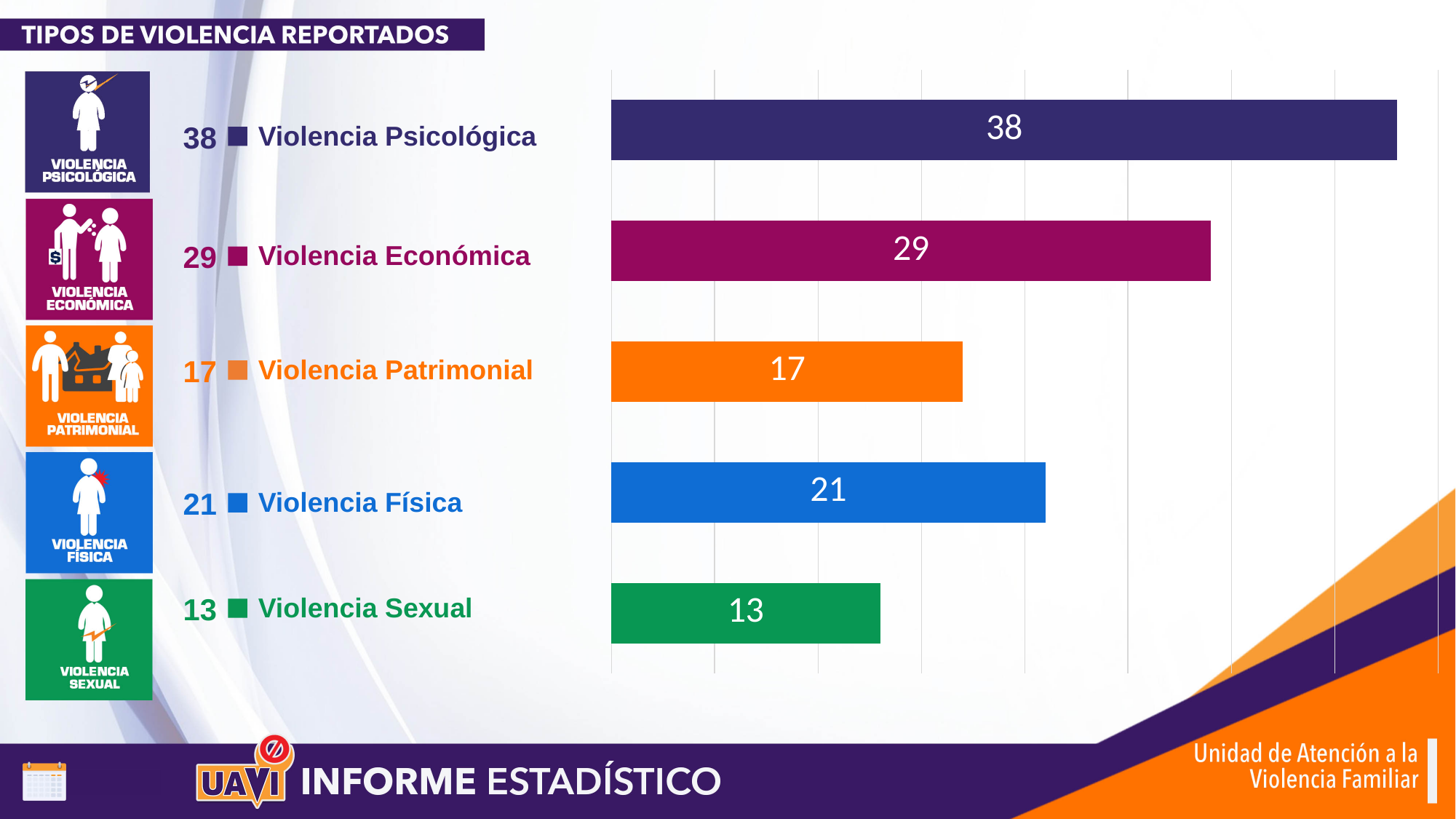
What is the value for Violencia Económica? 29 Which type of violence has the lowest reported value? Violencia Sexual What kind of chart is shown on the slide? Bar chart What is the value for Violencia Sexual? 13 Which type of violence has the highest reported value? Violencia Psicológica What is the value for Violencia Física? 21 What is the title of the slide's chart? TIPOS DE VIOLENCIA REPORTADOS What is the value for Violencia Patrimonial? 17 Which is larger, the value for Violencia Física or Violencia Patrimonial? Violencia Física How many types of violence are shown in the chart? 5 What is the value for Violencia Psicológica? 38 What is the difference between the values for Violencia Psicológica and Violencia Económica? 9